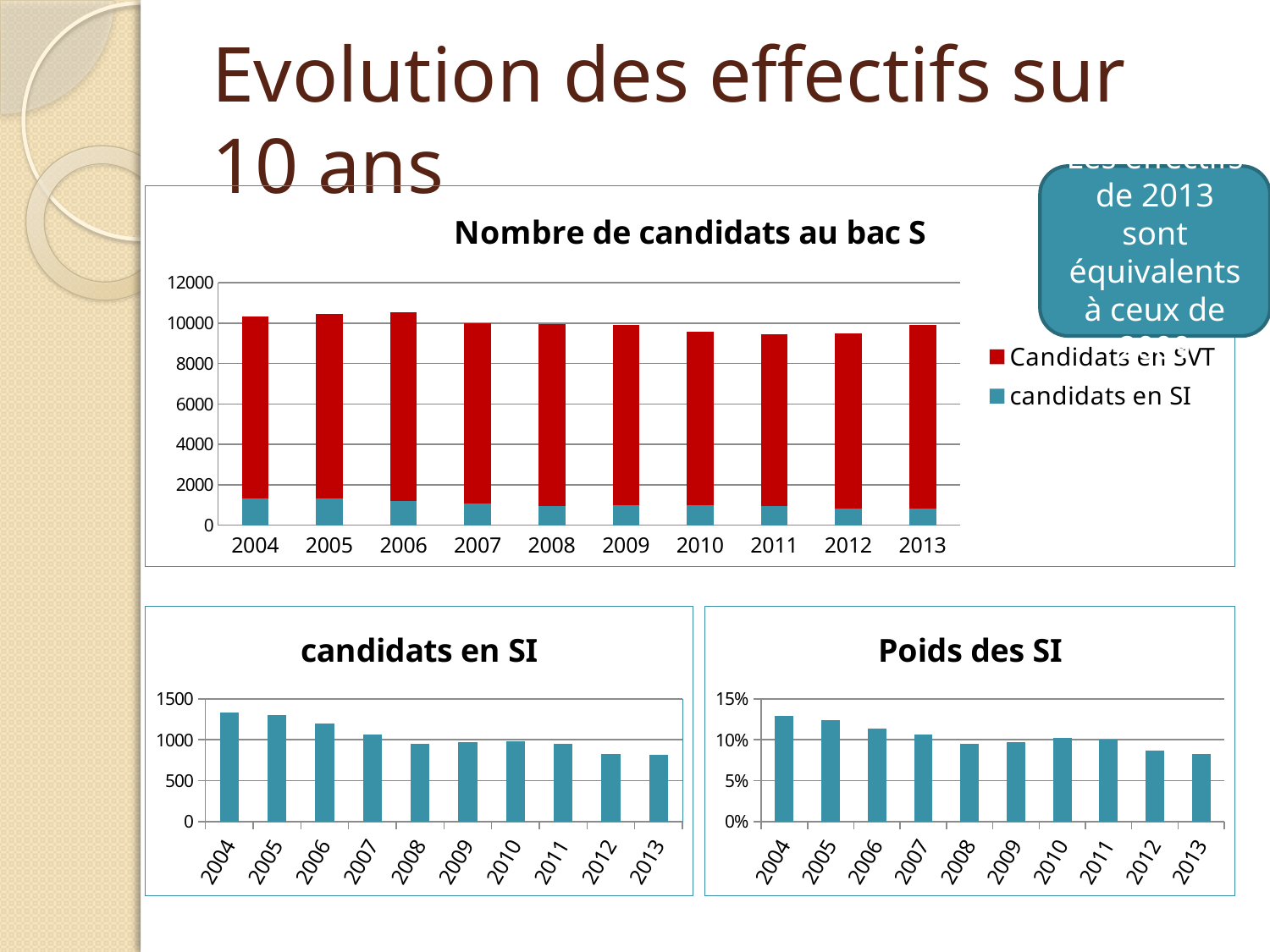
What kind of chart is the chart titled 'candidats en SI'? bar chart In the chart titled 'Poids des SI', which year has the highest value? 2004 In the chart titled 'Nombre de candidats au bac S', how many years are shown on the x axis? 10 In the chart titled 'Poids des SI', which is larger, the value for 2005 or the value for 2012? 2005 In the chart titled 'Nombre de candidats au bac S', is the total for 2004 greater or less than 10000? greater In the chart titled 'candidats en SI', do the values generally rise or fall from 2004 to 2013? fall In the chart titled 'Nombre de candidats au bac S', is the total for 2011 greater or less than 10000? less In the chart titled 'candidats en SI', is the value for 2008 greater or less than 1000? less In the chart titled 'Nombre de candidats au bac S', how many series does the legend list? 2 In the chart titled 'Nombre de candidats au bac S', which series is shown in red? Candidats en SVT In the chart titled 'candidats en SI', which year has the highest value? 2004